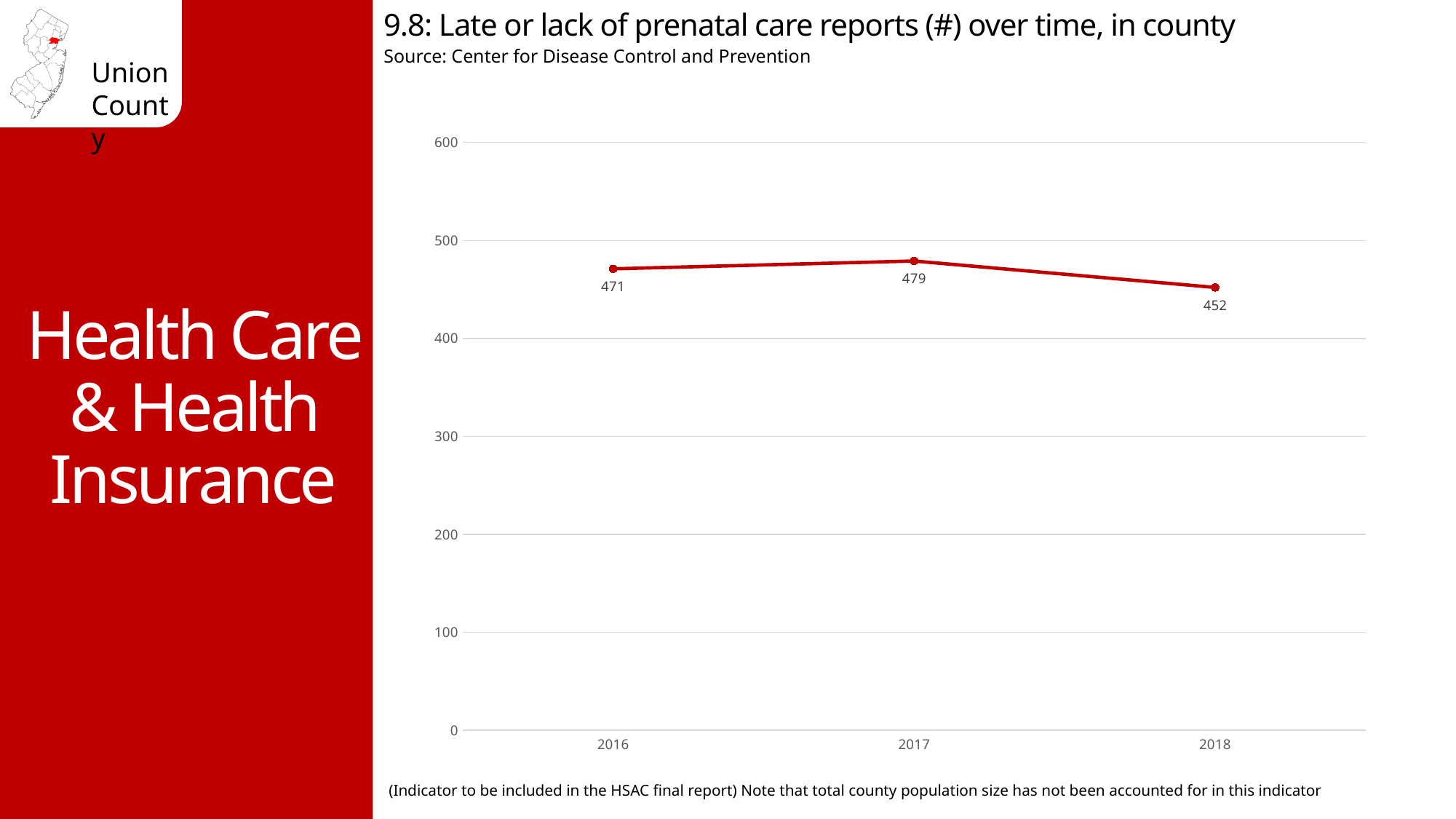
What is the difference between the 2017 and 2018 values? 27 What is the number of late or lack of prenatal care reports in 2018? 452 What is the number of late or lack of prenatal care reports in 2017? 479 What is the source of the data shown in the chart? Center for Disease Control and Prevention How many years are plotted on the chart? 3 Which year has the lowest number of late or lack of prenatal care reports? 2018 Which year has a larger value, 2016 or 2018? 2016 Which year has the highest number of late or lack of prenatal care reports? 2017 Is the value for 2018 greater or less than 500? less What is the number of late or lack of prenatal care reports in 2016? 471 What is the difference between the 2017 and 2016 values? 8 What kind of chart is shown on the slide? line chart